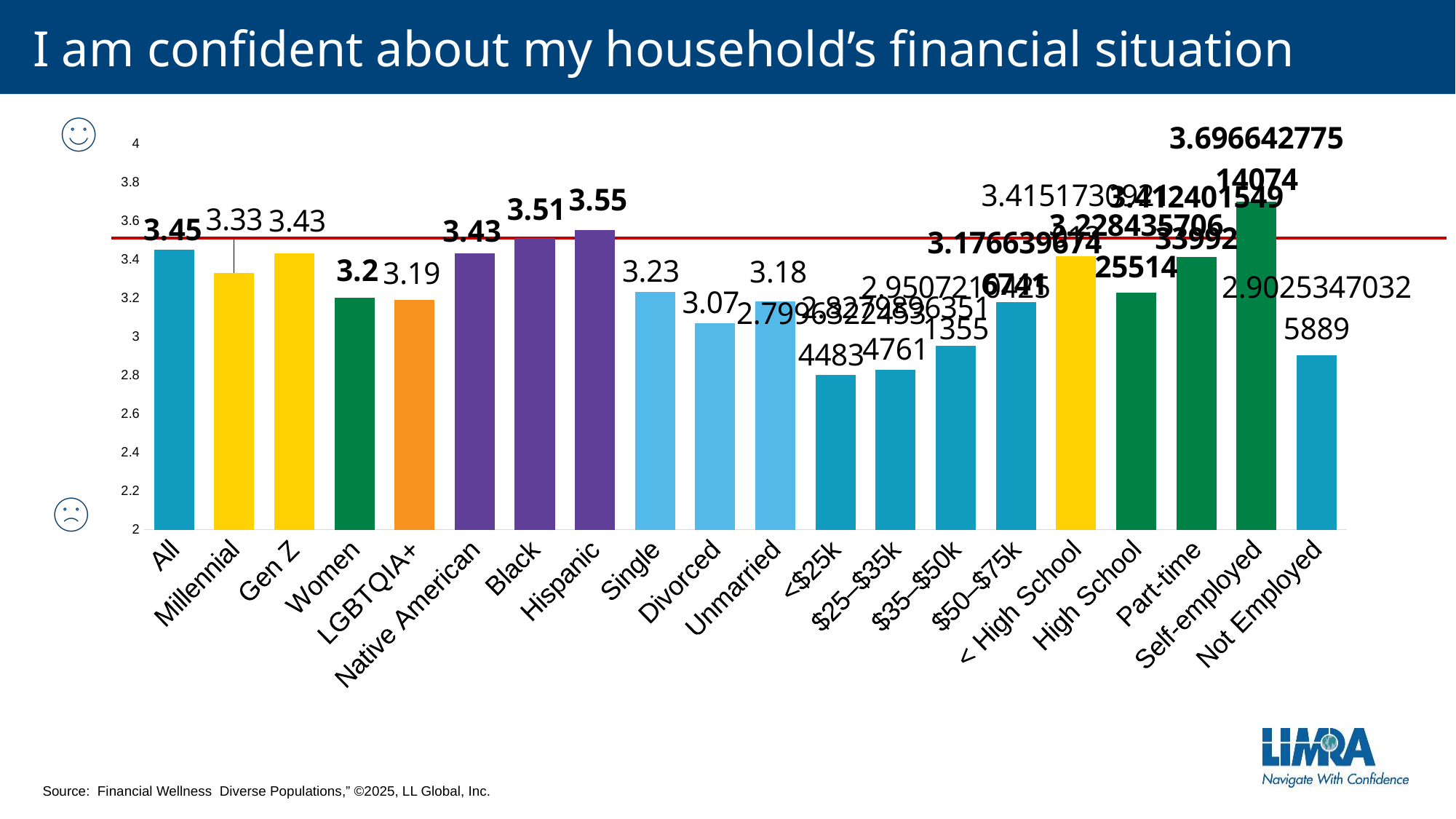
Is the value for <$25k greater or less than 3? less Which category has the lowest value? <$25k What is the value for Hispanic? 3.55 Is the value for Self-employed greater or less than 3.6? greater What is the value for All? 3.45 Which is larger, the value for Black or the value for Gen Z? Black What is the value for Women? 3.2 What is the value for Divorced? 3.07 What kind of chart is shown on the slide? bar chart What is the difference between the values for Hispanic and Black? 0.04 Which category has the highest value? Self-employed How many categories are shown on the x axis? 20